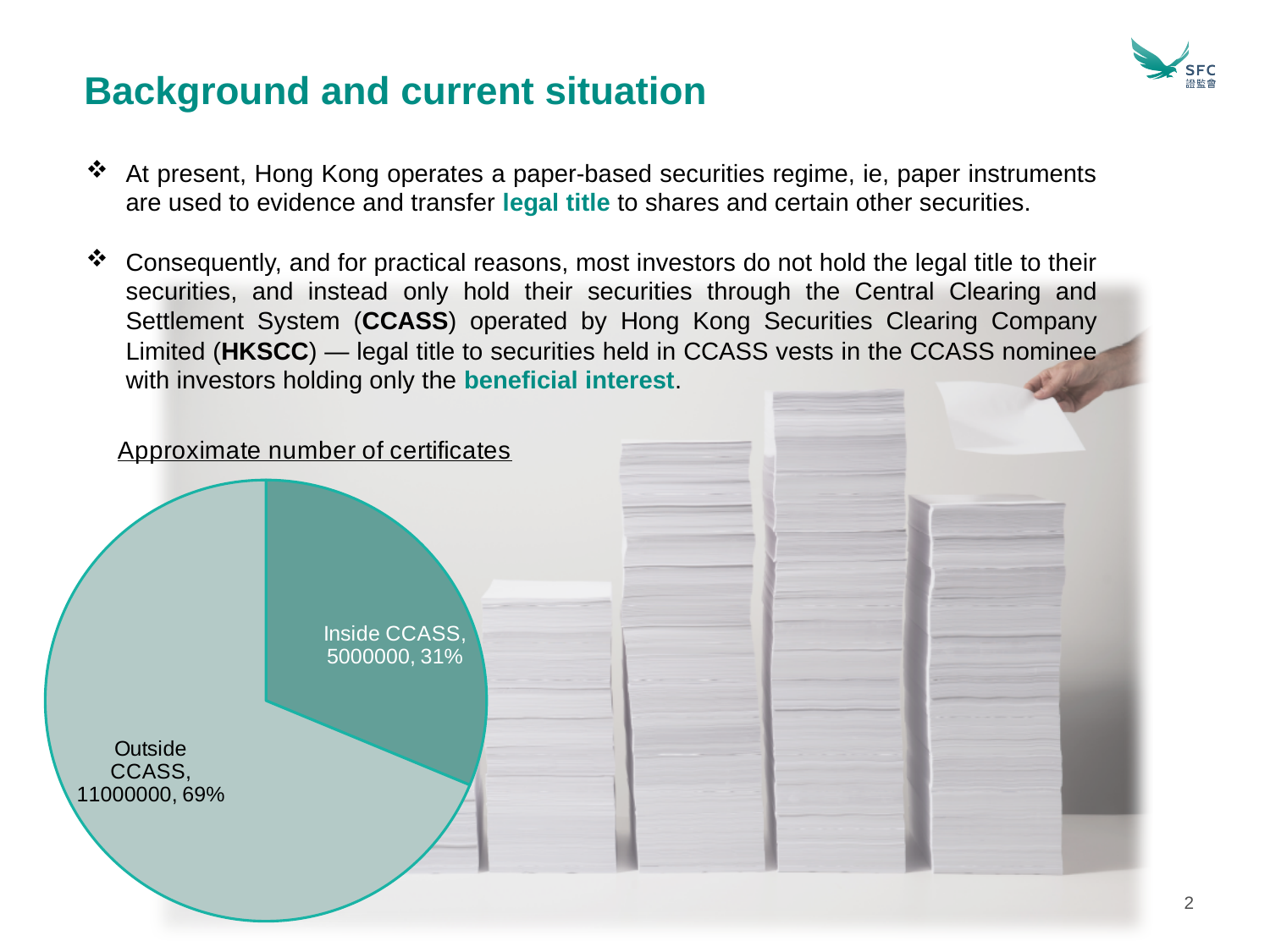
What is the total number of certificates shown in the pie chart? 16000000 Which category has the smaller number of certificates? Inside CCASS What is the approximate number of certificates outside CCASS? 11000000 What percentage of certificates are inside CCASS? 31% What is the title of the pie chart? Approximate number of certificates How many slices does the pie chart have? 2 Which category has the larger number of certificates? Outside CCASS What kind of chart is shown on the slide? pie chart How many more certificates are outside CCASS than inside CCASS? 6000000 What percentage of certificates are outside CCASS? 69% What is the approximate number of certificates inside CCASS? 5000000 Is the number of certificates inside CCASS larger or smaller than the number outside CCASS? smaller